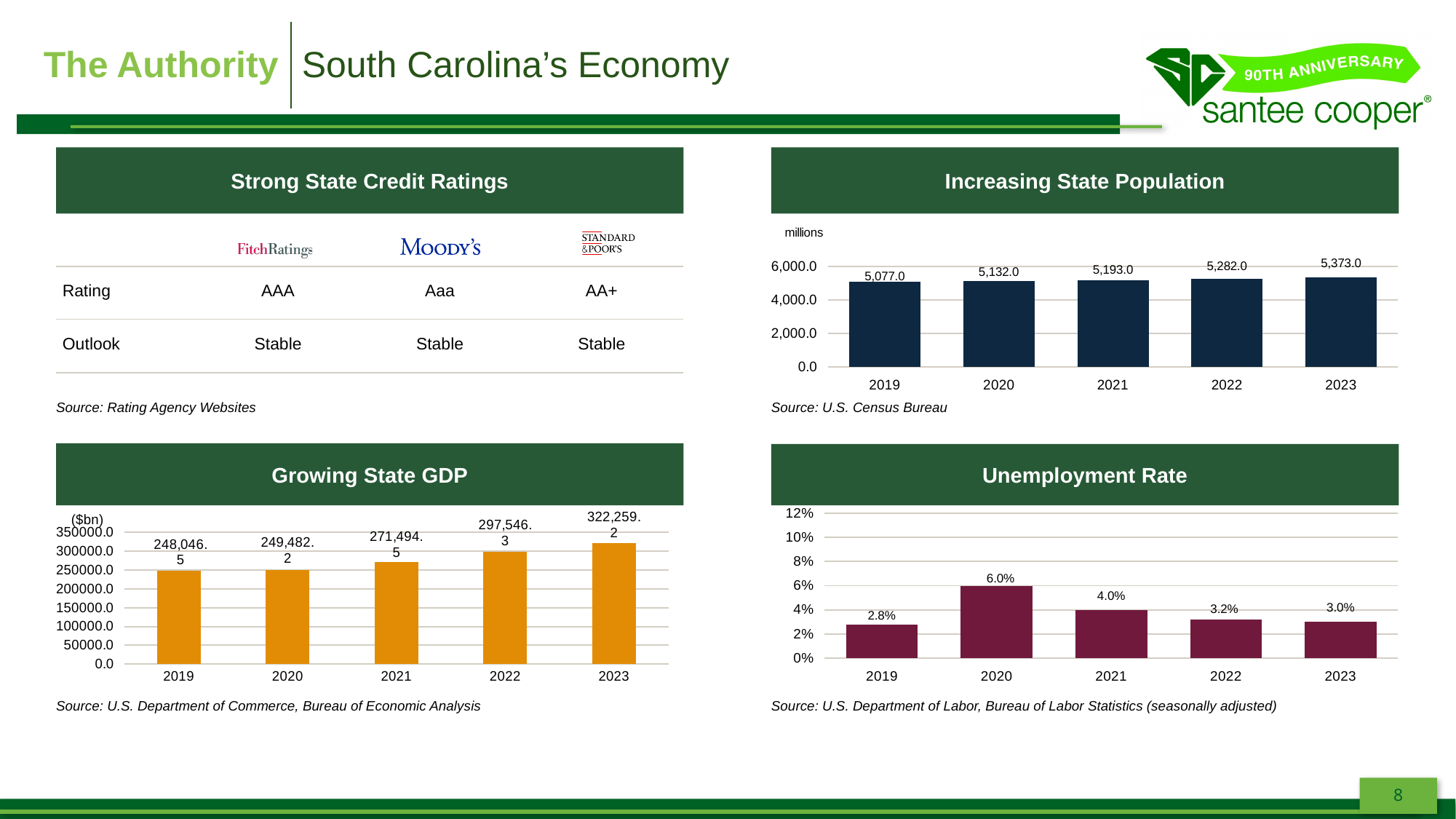
In the Growing State GDP chart, which year has the highest value? 2023 In the Increasing State Population chart, what is the difference between the 2023 and 2019 values? 296.0 In the Increasing State Population chart, what is the value for 2023? 5,373.0 In the Unemployment Rate chart, what is the value for 2020? 6.0% In the Growing State GDP chart, how many years are shown on the x axis? 5 In the Growing State GDP chart, is the value for 2022 greater or less than 250000.0? greater In the Unemployment Rate chart, which year has the highest value? 2020 In the Increasing State Population chart, do the values rise or fall from 2019 to 2023? rise What kind of chart is the Unemployment Rate chart? bar chart In the Unemployment Rate chart, which is larger, the value for 2021 or the value for 2022? 2021 In the Increasing State Population chart, which year has the lowest value? 2019 In the Growing State GDP chart, what is the value for 2021? 271,494.5